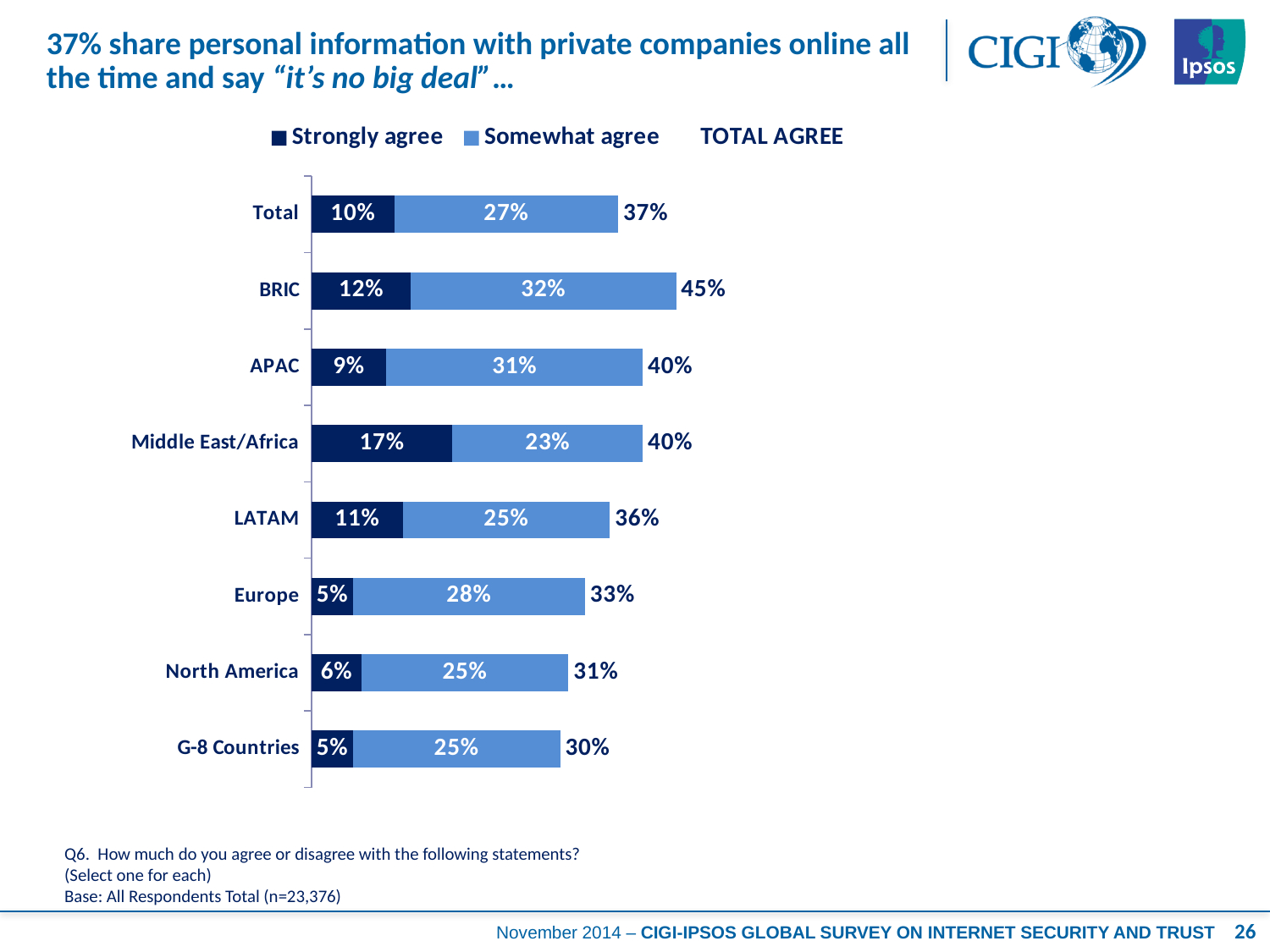
What kind of chart is shown on the slide? Stacked bar chart Which category has the highest 'Strongly agree' value? Middle East/Africa What is the 'Somewhat agree' value for BRIC? 32% Which category has the highest TOTAL AGREE value? BRIC How many series does the legend list? 3 What is the TOTAL AGREE value for Europe? 33% Which category has the lowest TOTAL AGREE value? G-8 Countries What is the difference between the TOTAL AGREE values for BRIC and G-8 Countries? 15% What is the 'Strongly agree' value for Middle East/Africa? 17% What is the total of the stacked bar for North America? 31% How many categories are shown on the chart? 8 Which is larger, the 'Somewhat agree' value for APAC or for LATAM? APAC